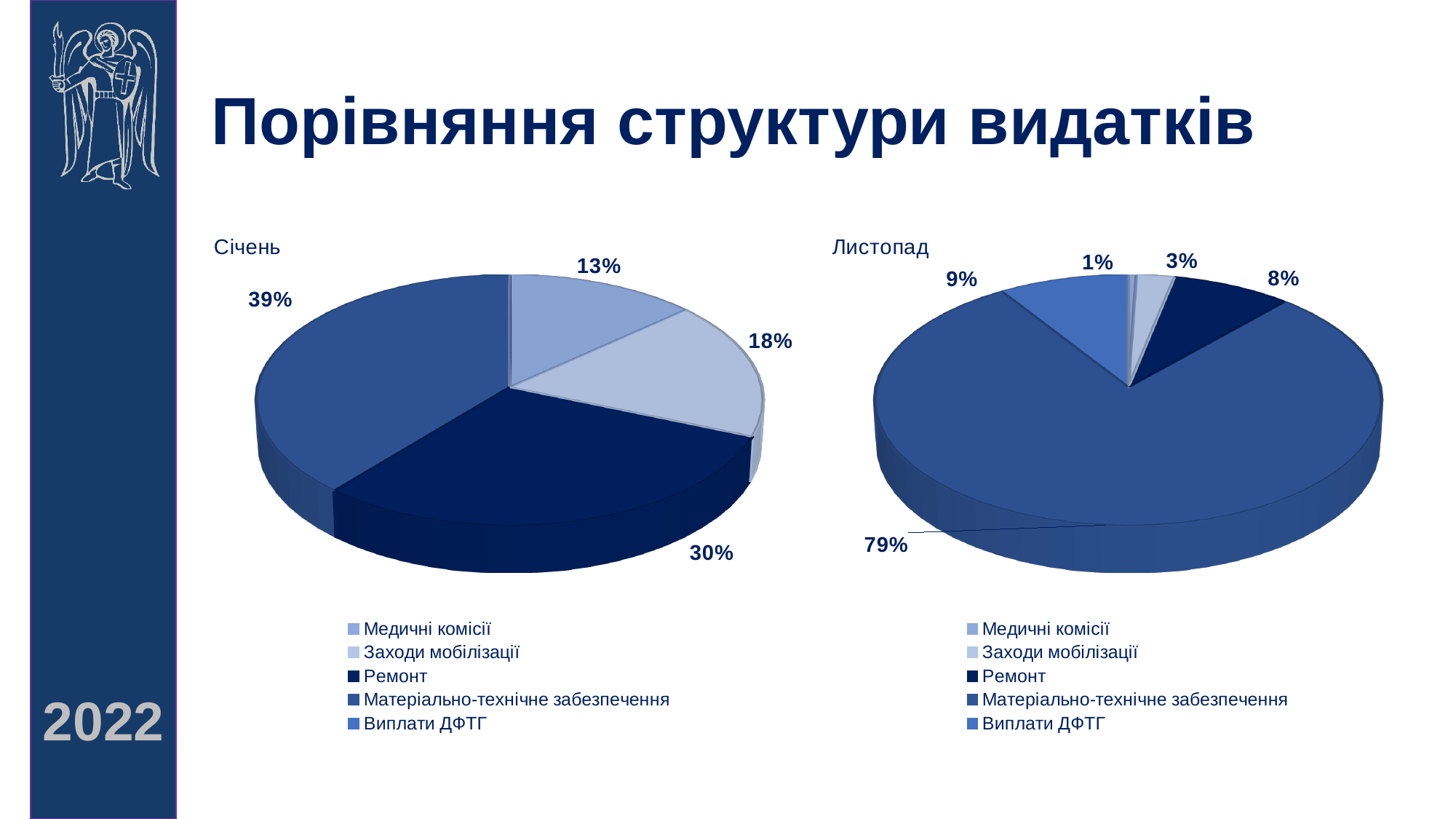
In the Листопад chart, which category has the smallest share? Медичні комісії What is the difference between the share of Ремонт in the Січень chart and in the Листопад chart? 22 percentage points In the Листопад chart, what share does Виплати ДФТГ have? 9% In the Січень chart, what share does Заходи мобілізації have? 18% What type of charts are shown on the slide? Pie charts In the Січень chart, what share does Ремонт have? 30% How many categories does the legend of the Листопад chart list? 5 In the Листопад chart, what share does Матеріально-технічне забезпечення have? 79% What is the title of the slide? Порівняння структури видатків In the Січень chart, which is larger: the share of Медичні комісії or the share of Заходи мобілізації? Заходи мобілізації In the Січень chart, what share does Матеріально-технічне забезпечення have? 39% In the Січень chart, which category has the largest share? Матеріально-технічне забезпечення